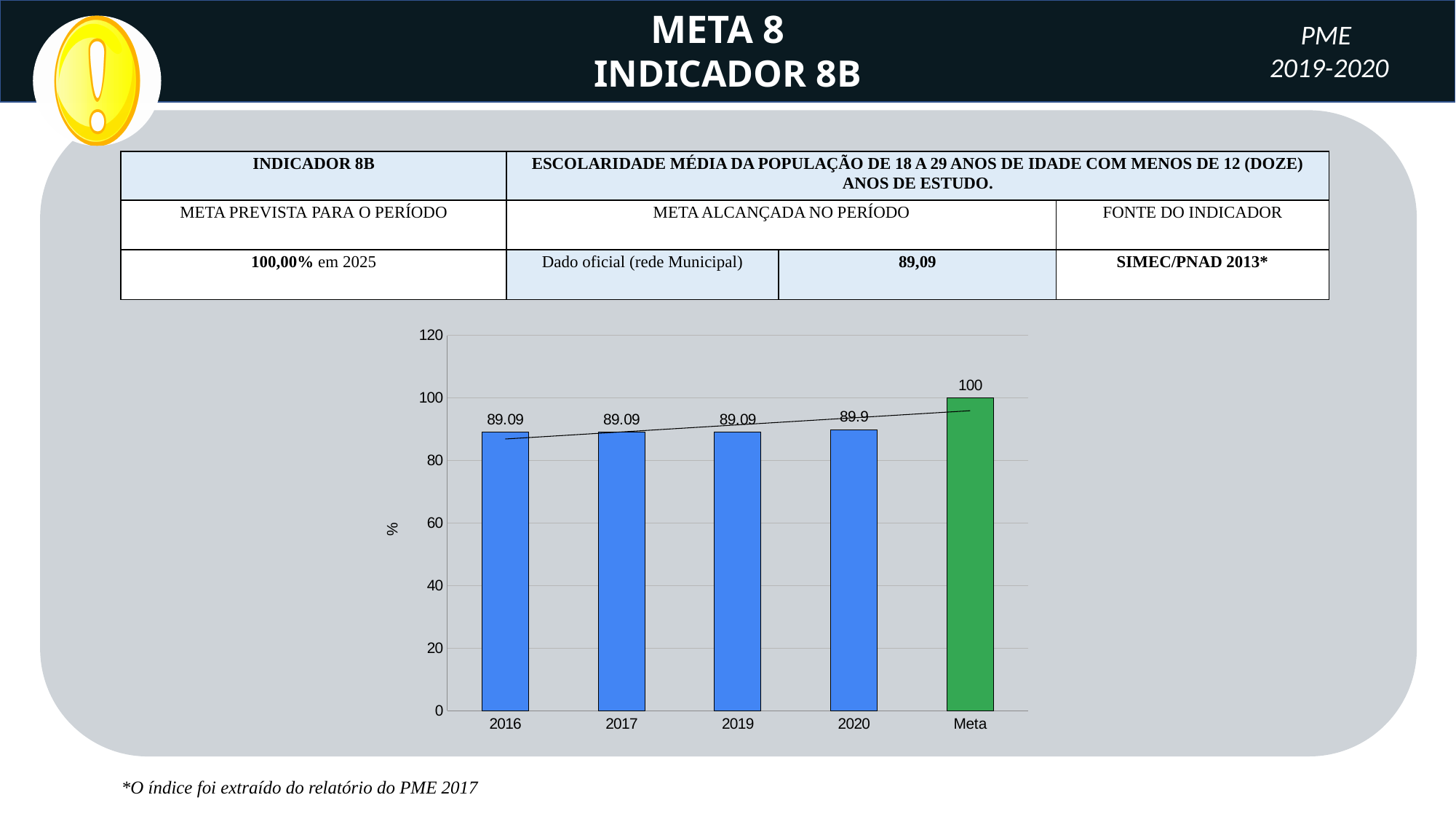
How many categories are shown on the x axis? 5 Which is larger, the value for 2020 or the value for 2017? 2020 What kind of chart is shown? bar chart What is the value for Meta? 100 What is the value for 2019? 89.09 What colour is the Meta bar? green What is the difference between the Meta value and the 2020 value? 10.1 What is the value for 2020? 89.9 What is the label of the vertical axis? % Is the value for 2017 greater or less than 80? greater What is the value for 2016? 89.09 Which category has the highest value? Meta